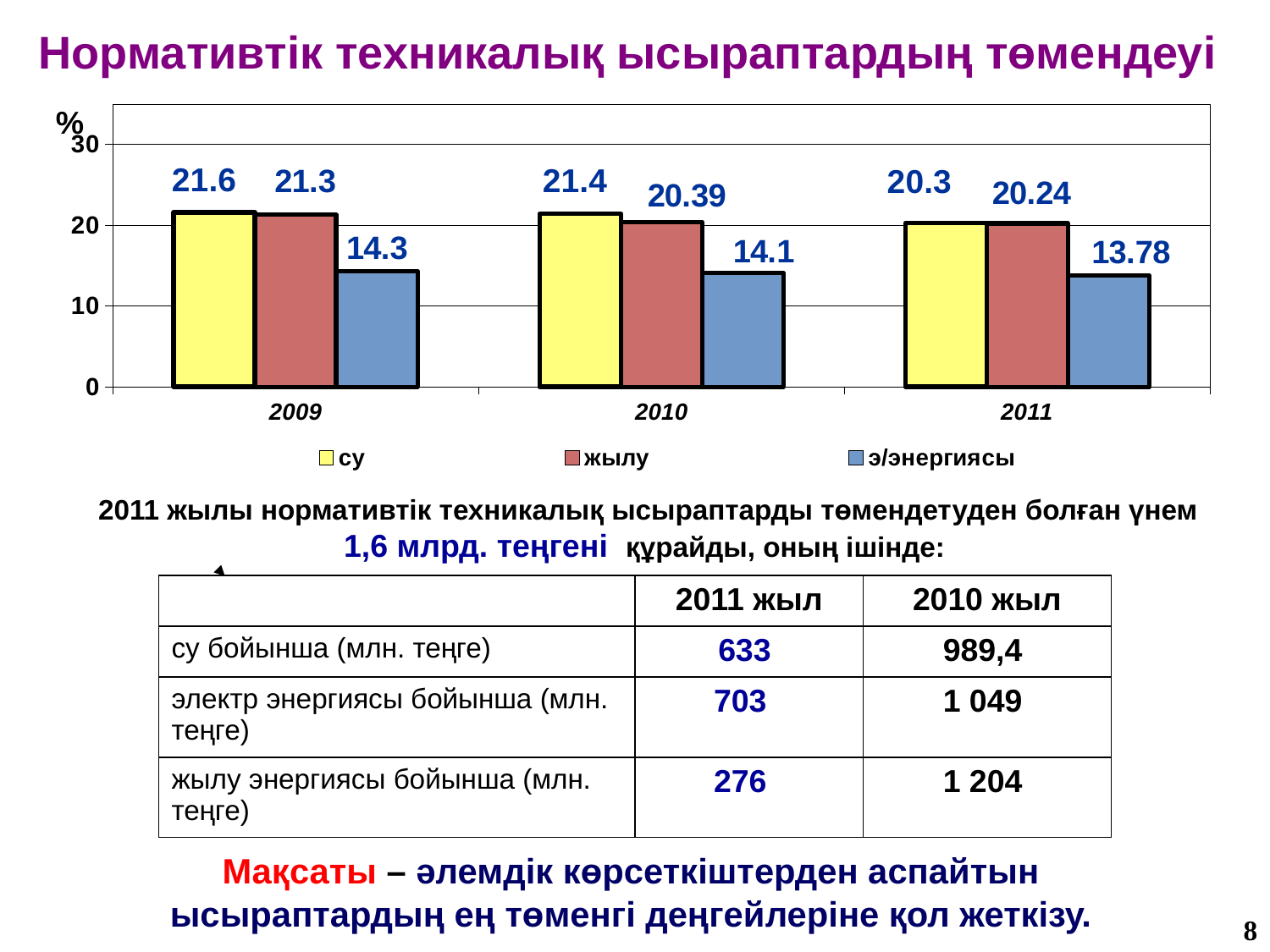
Which year has the lowest value for э/энергиясы? 2011 How many years are shown on the x axis of the chart? 3 Is the value for жылу in 2011 greater or less than 10? greater How many series does the chart legend list? 3 What is the value for э/энергиясы in 2011? 13.78 What is the difference between the су value in 2009 and the су value in 2011? 1.3 What is the value for су in 2009? 21.6 Which year has the highest value for су? 2009 What is the value for жылу in 2010? 20.39 Which is larger in 2010: the value for су or the value for э/энергиясы? су Do the values for э/энергиясы rise or fall from 2009 to 2011? fall What kind of chart is shown on the slide? bar chart